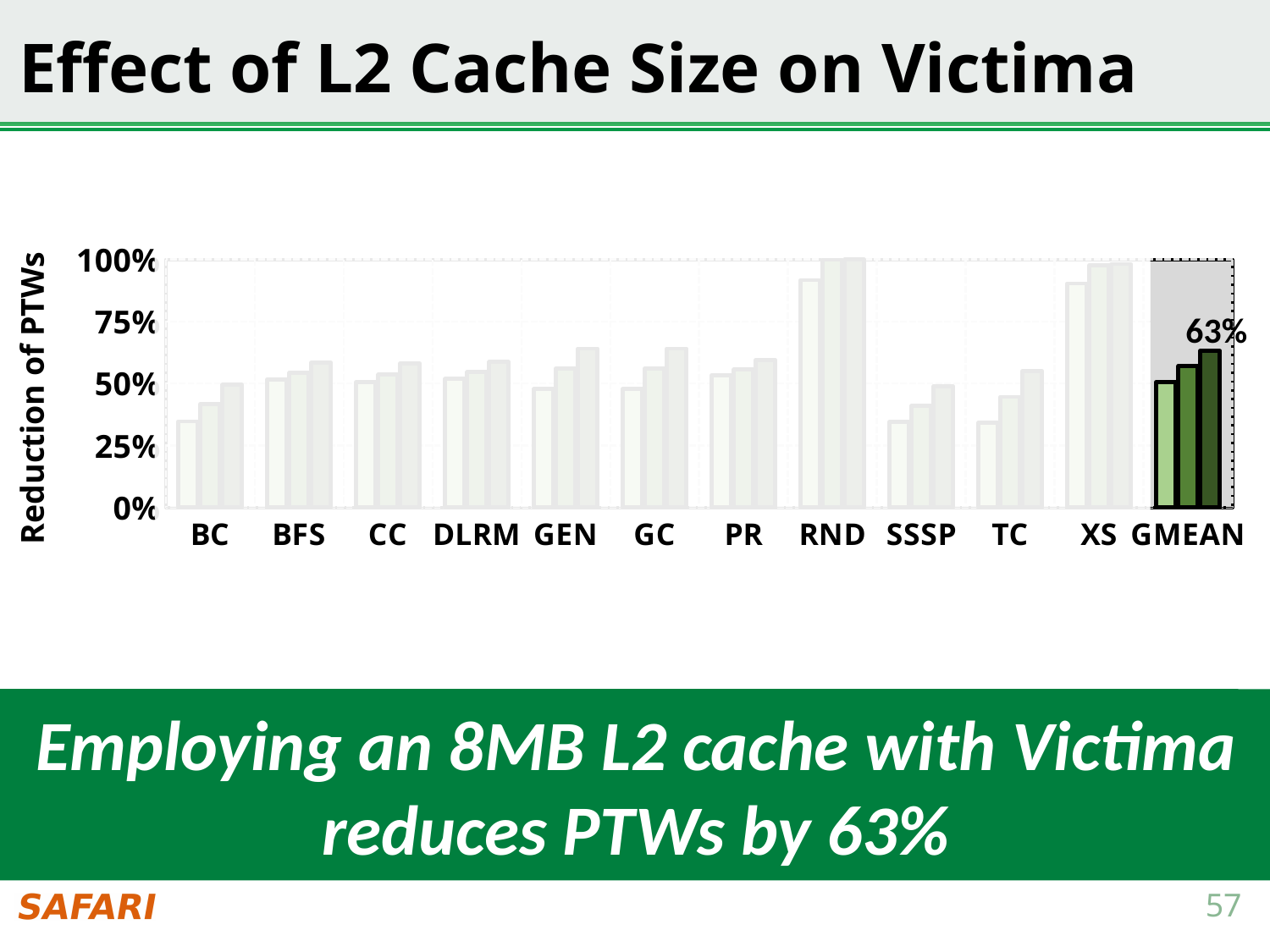
Which category has taller bars, GMEAN or SSSP? GMEAN Within each category, do the three bars rise or fall from left to right? rise What kind of chart is shown on the slide? bar chart Is the value of the tallest RND bar greater or less than 75%? greater Is the value of the leftmost TC bar greater or less than 50%? less Which category has taller bars, RND or BC? RND What value is labelled on the tallest GMEAN bar in the chart? 63% Is the value of the leftmost BC bar greater or less than 50%? less What is the label of the y axis of the chart? Reduction of PTWs How many categories are shown along the x axis of the chart? 12